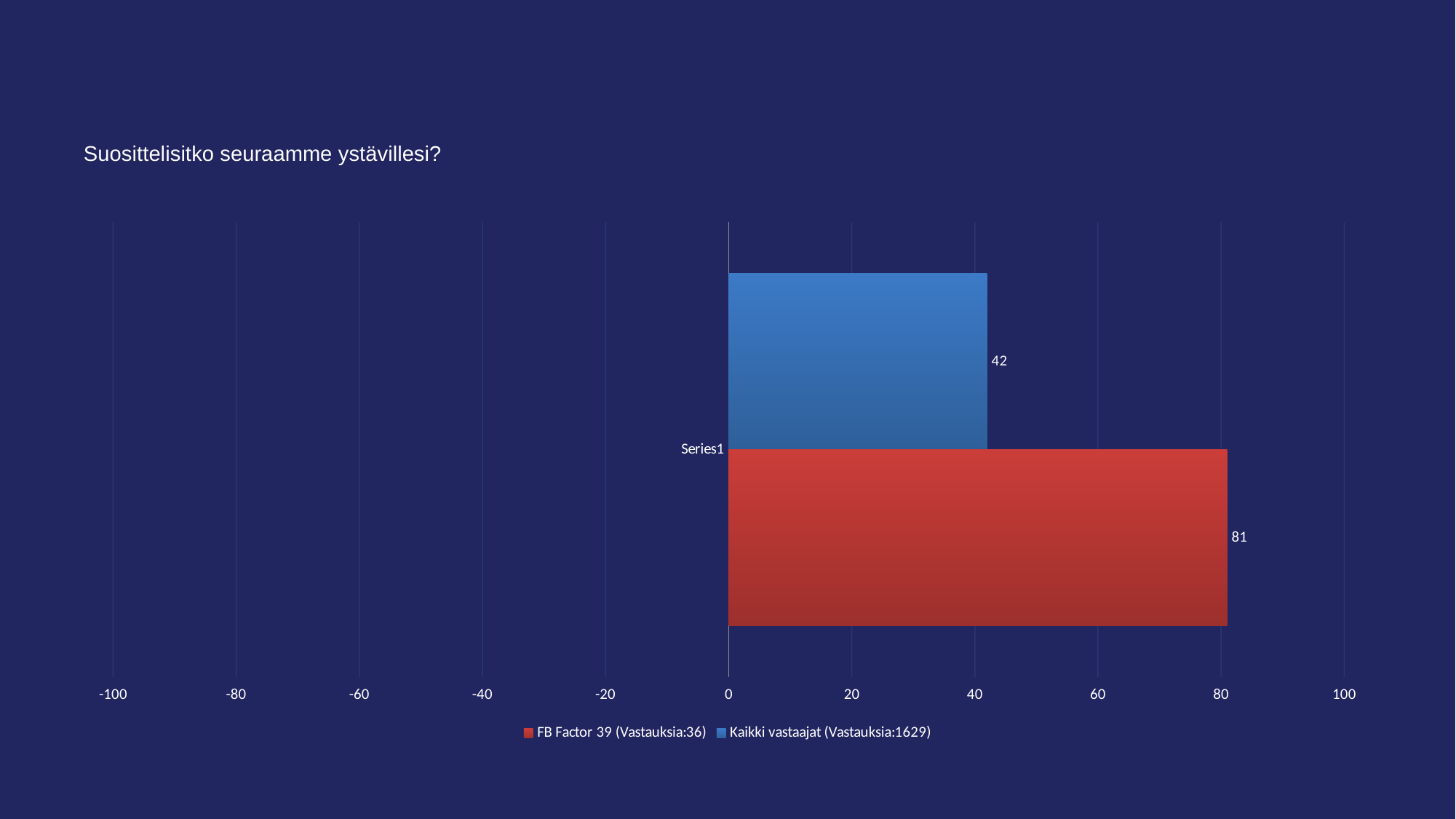
Is the value for FB Factor 39 greater or less than 80? greater How many series does the legend list? 2 What is the difference between the FB Factor 39 value and the Kaikki vastaajat value? 39 What colour is the bar for Kaikki vastaajat (Vastauksia:1629)? blue What kind of chart is shown? bar chart What is the value for Kaikki vastaajat (Vastauksia:1629)? 42 What is the title of the chart? Suosittelisitko seuraamme ystävillesi? Which series has the lower value? Kaikki vastaajat (Vastauksia:1629) Which series has the higher value? FB Factor 39 (Vastauksia:36) Is the value for Kaikki vastaajat greater or less than 60? less Is the value for FB Factor 39 larger or smaller than the value for Kaikki vastaajat? larger What is the value for FB Factor 39 (Vastauksia:36)? 81